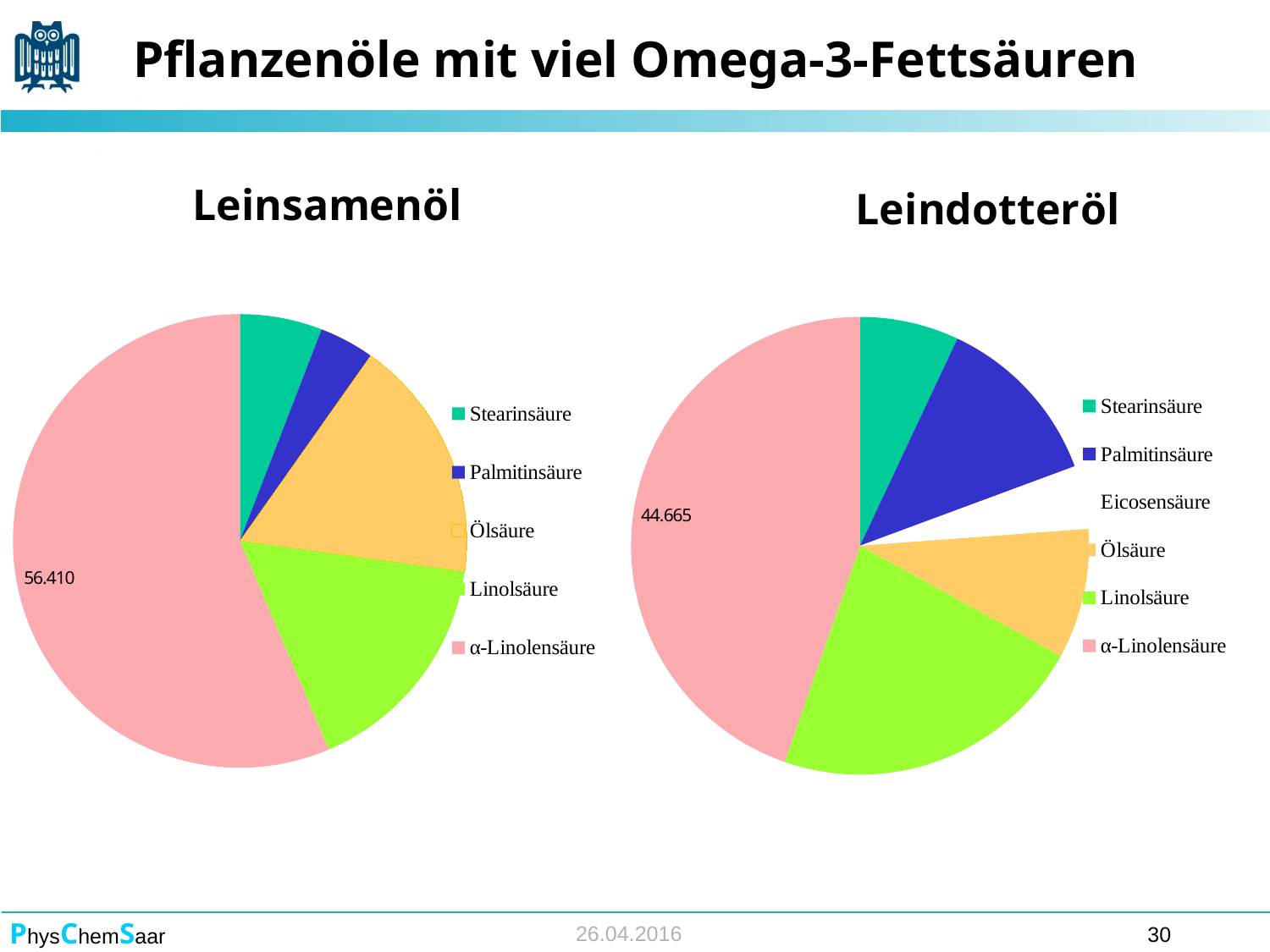
How many entries does the legend of the Leinsamenöl chart list? 5 What is the difference between the α-Linolensäure value in the Leinsamenöl chart and the α-Linolensäure value in the Leindotteröl chart? 11.745 In the Leinsamenöl chart, what value is shown for α-Linolensäure? 56.410 In the Leinsamenöl chart, which fatty acid has the largest slice? α-Linolensäure Which chart shows the larger value for α-Linolensäure, Leinsamenöl or Leindotteröl? Leinsamenöl In the Leindotteröl chart, what value is shown for α-Linolensäure? 44.665 In the Leindotteröl chart, which slice is larger, Palmitinsäure or Stearinsäure? Palmitinsäure What type of chart is the Leinsamenöl chart? Pie chart In the Leindotteröl chart, which fatty acid has the largest slice? α-Linolensäure In the Leindotteröl chart, which slice is larger, Linolsäure or Ölsäure? Linolsäure In the Leinsamenöl chart, which fatty acid has the smallest slice? Palmitinsäure How many entries does the legend of the Leindotteröl chart list? 6